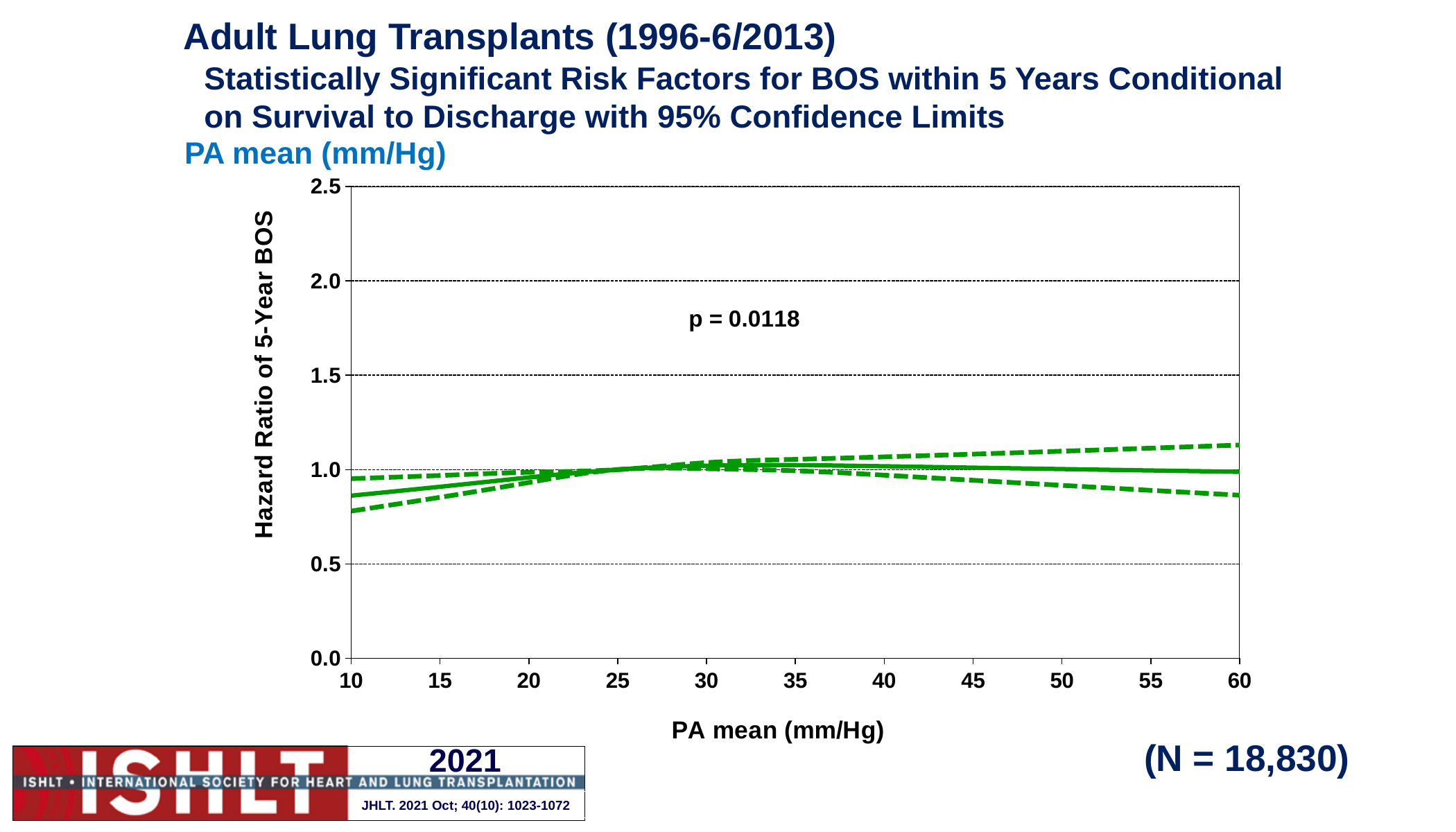
How many lines are plotted on the chart? 3 What is the highest value shown on the y-axis? 2.5 What is the label of the y-axis? Hazard Ratio of 5-Year BOS What is the p-value printed on the chart? p = 0.0118 What kind of chart is shown on the slide? line chart Does the hazard ratio (solid line) rise or fall as PA mean increases from 10 to 25 mm/Hg? rise Is the upper dashed confidence limit at a PA mean of 60 mm/Hg greater or less than 1.0? greater Is the lower dashed confidence limit at a PA mean of 10 mm/Hg greater or less than 1.0? less Is the hazard ratio (solid line) at a PA mean of 10 mm/Hg greater or less than 1.0? less